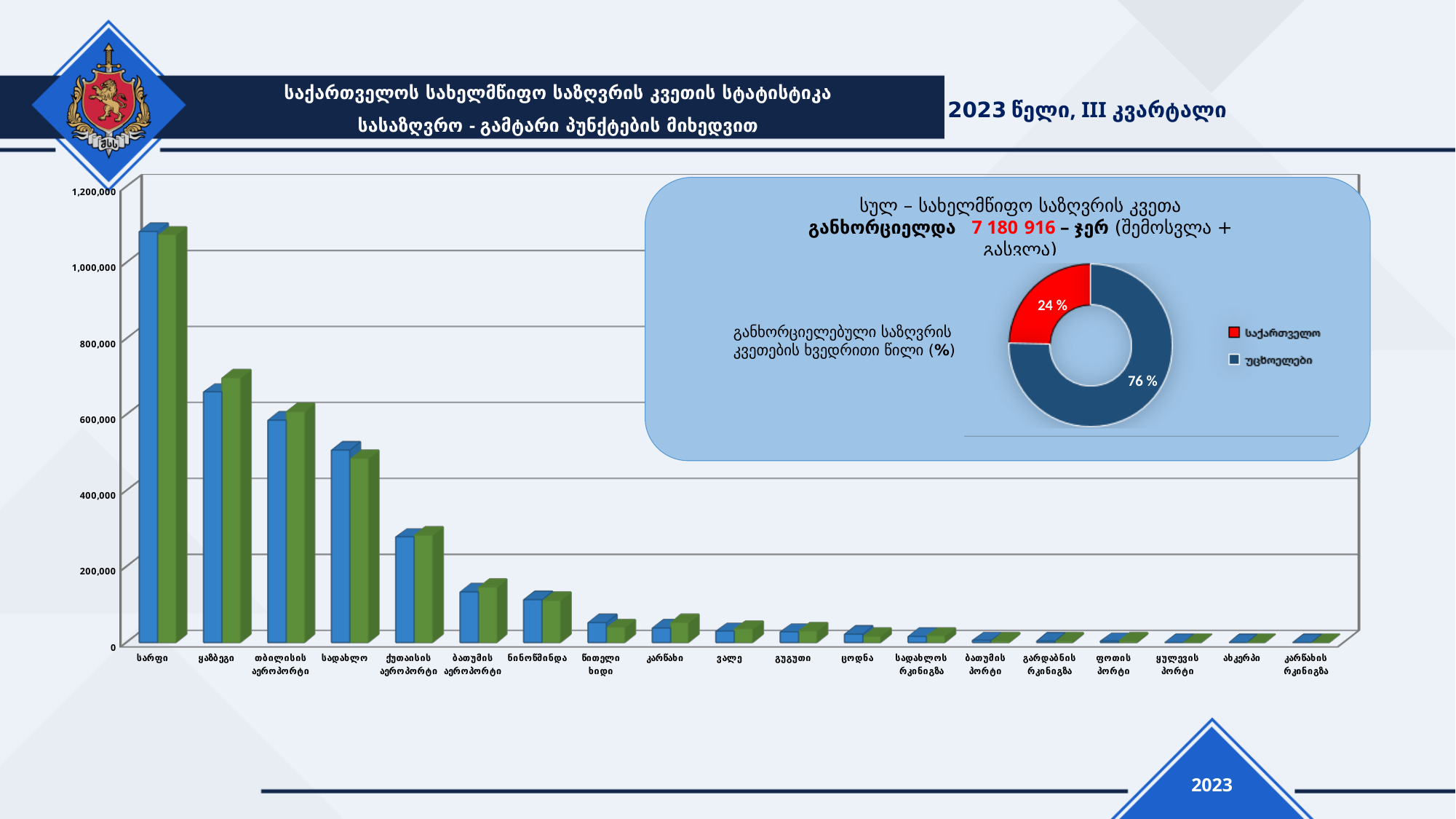
What kind of chart is the large chart on the left side of the slide? bar chart In the bar chart on the left, is the value for ქუთაისის აეროპორტი greater or less than 200,000? greater In the bar chart on the left, which has a larger value, სარფი or ყაზბეგი? სარფი In the donut chart on the right, what share is shown for უცხოელები? 76 % In the bar chart on the left, is the value for სარფი greater or less than 1,000,000? greater In the bar chart on the left, do the values generally rise or fall from left to right along the x axis? fall In the bar chart on the left, is the value for ყაზბეგი greater or less than 800,000? less In the donut chart on the right, what share is shown for საქართველო? 24 % How many entries does the legend of the donut chart on the right list? 2 In the bar chart on the left, which category has the highest value? სარფი In the bar chart on the left, how many categories are shown on the x axis? 19